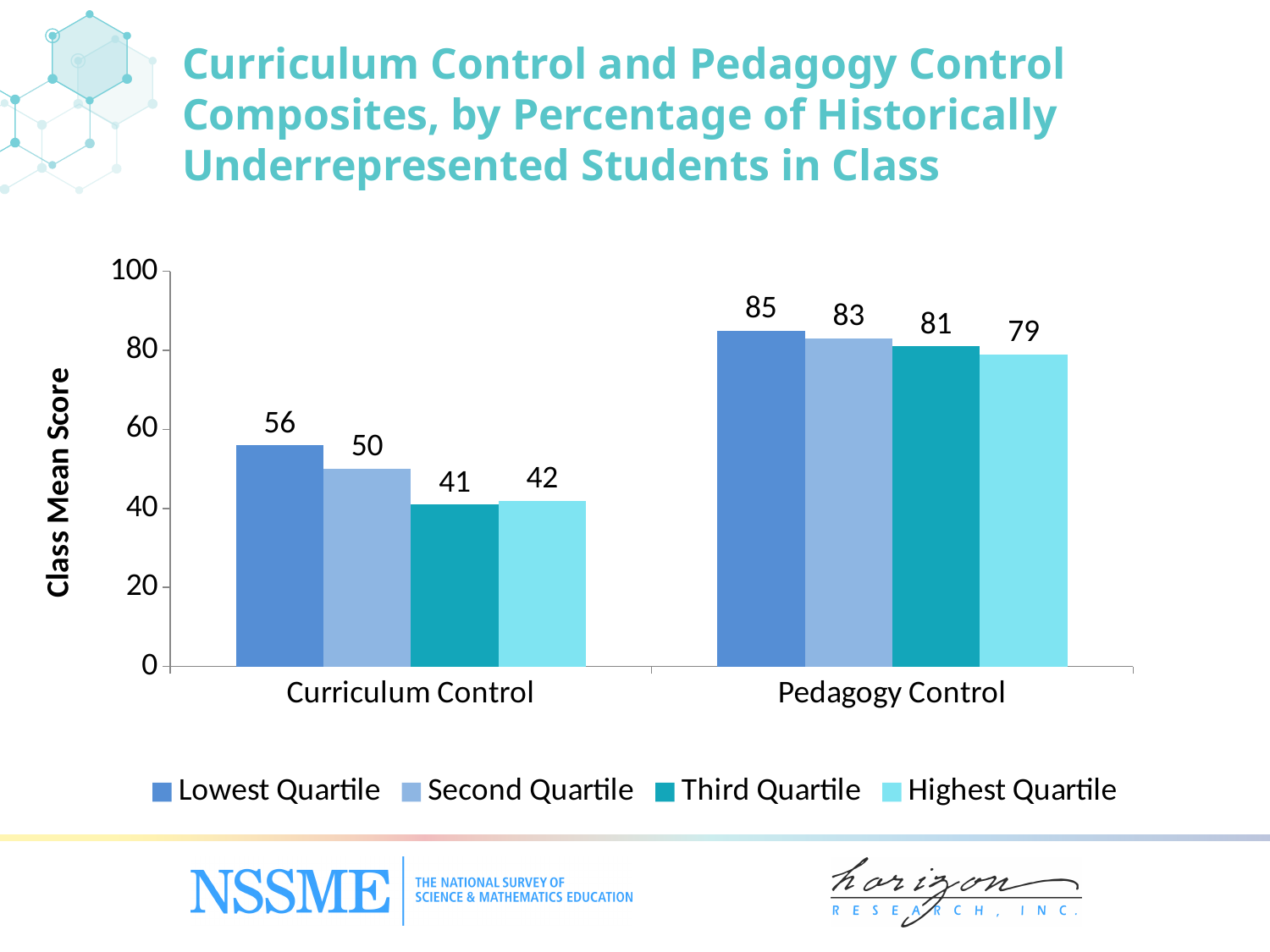
How many categories are shown on the x axis? 2 Which is larger for Curriculum Control: the Second Quartile score or the Highest Quartile score? Second Quartile What is the Class Mean Score for the Highest Quartile on Pedagogy Control? 79 How many series does the legend list? 4 What is the difference between the Second Quartile scores for Pedagogy Control and Curriculum Control? 33 Is the Third Quartile score for Pedagogy Control greater or less than 60? greater What is the difference between the Lowest Quartile and Highest Quartile scores for Curriculum Control? 14 What is the Class Mean Score for the Third Quartile on Curriculum Control? 41 Which quartile has the highest Class Mean Score for Pedagogy Control? Lowest Quartile Which quartile has the lowest Class Mean Score for Curriculum Control? Third Quartile What is the Class Mean Score for the Lowest Quartile on Curriculum Control? 56 What kind of chart is shown on the slide? Bar chart